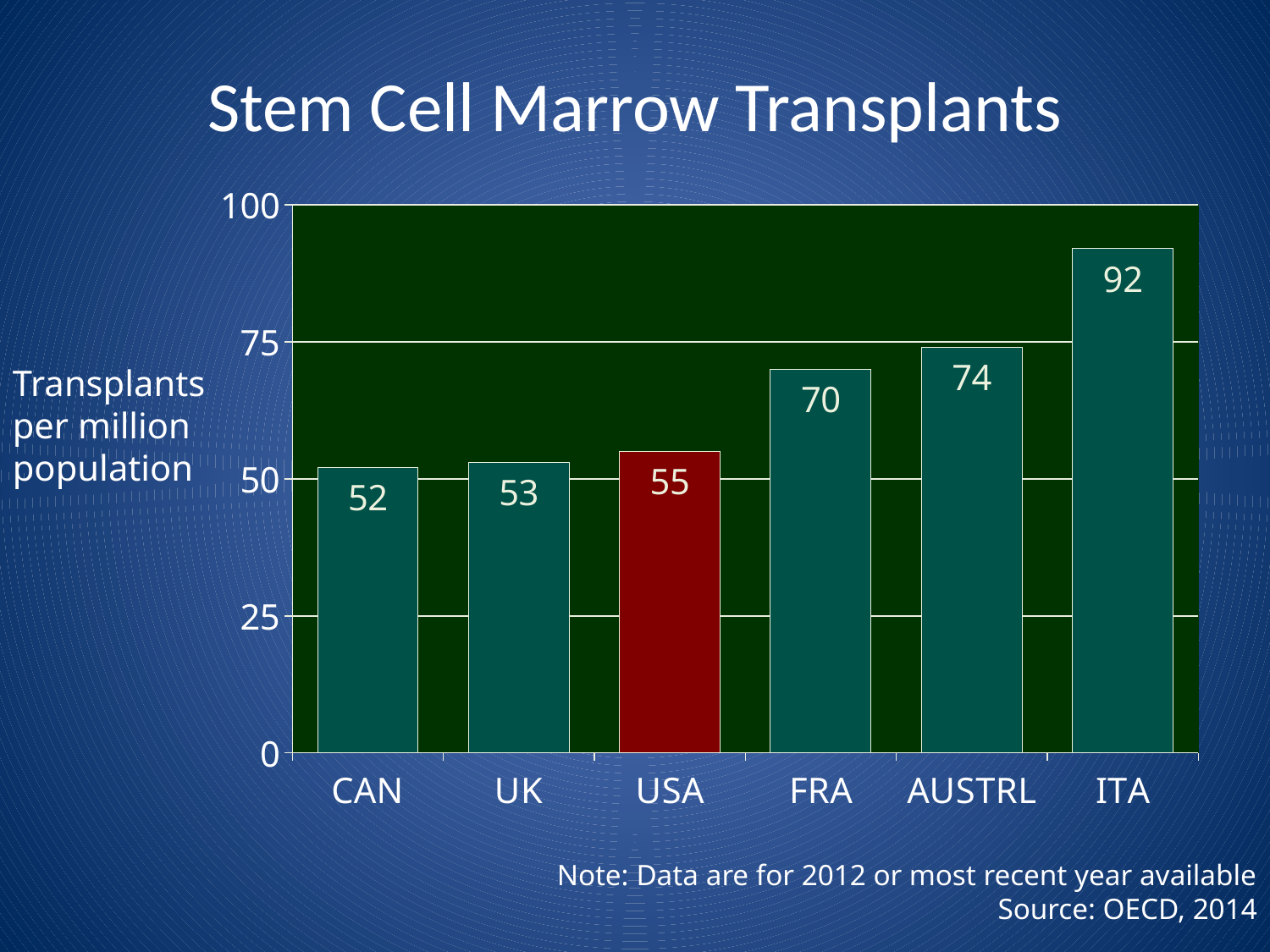
How many countries are shown in the chart? 6 What kind of chart is shown on the slide? bar chart What is the difference between the values for FRA and UK? 17 What is the value for USA in the Stem Cell Marrow Transplants chart? 55 Which is larger, the value for FRA or the value for AUSTRL? AUSTRL Is the value for FRA greater or less than 75? less What is the value for ITA? 92 What is the difference between the values for ITA and USA? 37 Which country has the highest number of transplants per million population? ITA Which country has the lowest number of transplants per million population? CAN Which country's bar is coloured red? USA What is the value for AUSTRL? 74